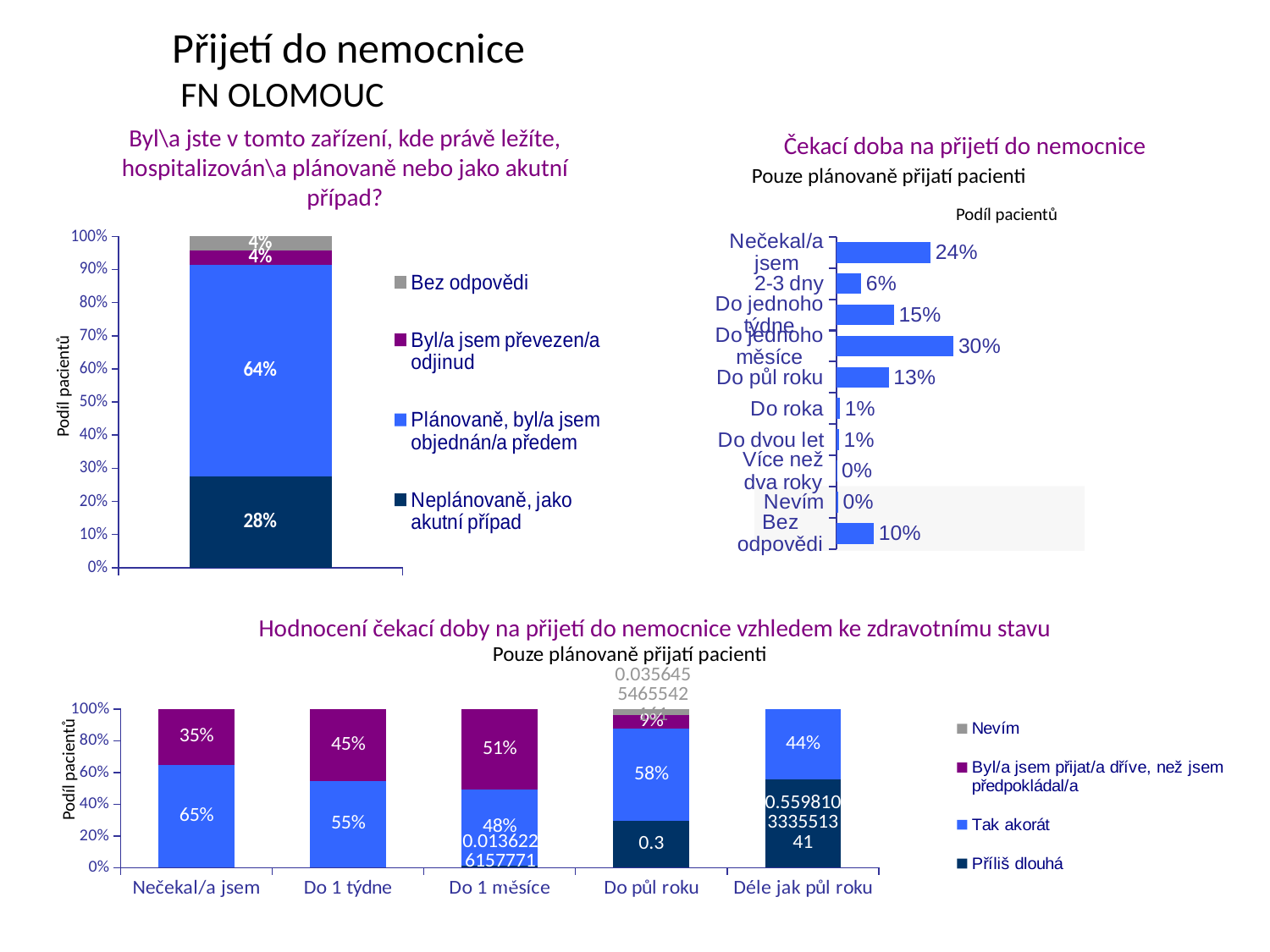
In the top-right chart 'Čekací doba na přijetí do nemocnice', which is larger: 'Nečekal/a jsem' or 'Do jednoho týdne'? Nečekal/a jsem In the top-right chart 'Čekací doba na přijetí do nemocnice', what is the value for 'Bez odpovědi'? 10% In the bottom chart 'Hodnocení čekací doby...', what is the 'Byl/a jsem přijat/a dříve, než jsem předpokládal/a' value for 'Do 1 měsíce'? 51% In the top-left chart 'Byl\a jste v tomto zařízení...', what is the difference between the 'Plánovaně' and 'Neplánovaně' values? 36% In the top-right chart 'Čekací doba na přijetí do nemocnice', what is the value for 'Do jednoho měsíce'? 30% In the top-right chart 'Čekací doba na přijetí do nemocnice', what type of chart is it? Bar chart In the top-left chart 'Byl\a jste v tomto zařízení...', how many series does the legend list? 4 In the top-right chart 'Čekací doba na přijetí do nemocnice', how many categories are shown? 10 In the bottom chart 'Hodnocení čekací doby...', what is the 'Tak akorát' value for 'Nečekal/a jsem'? 65% In the top-left chart 'Byl\a jste v tomto zařízení...', what is the value for 'Neplánovaně, jako akutní případ'? 28% In the top-left chart 'Byl\a jste v tomto zařízení...', what is the value for 'Plánovaně, byl/a jsem objednán/a předem'? 64% In the top-right chart 'Čekací doba na přijetí do nemocnice', which category has the highest value? Do jednoho měsíce